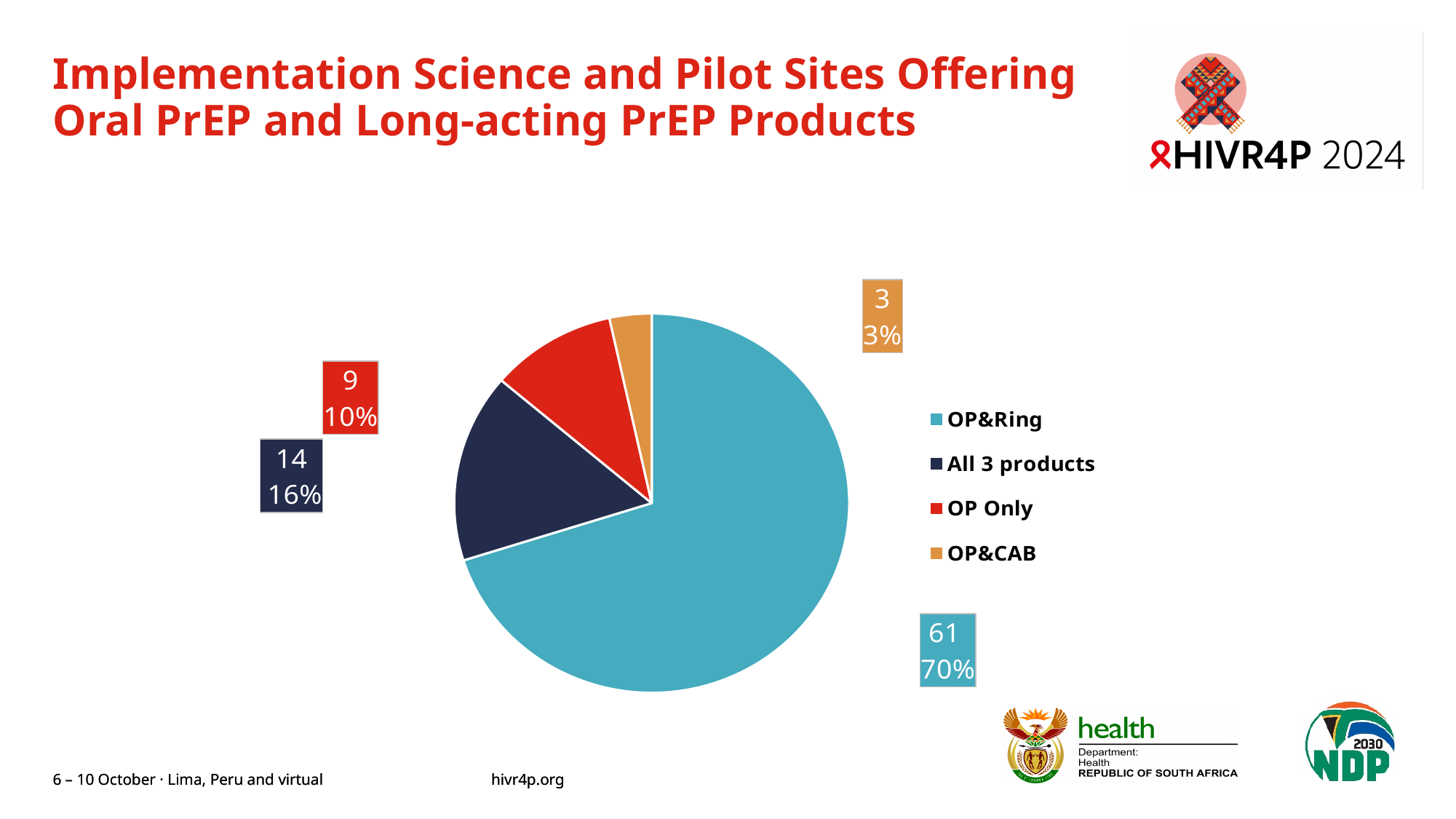
How many sites offer OP&Ring? 61 What is the difference in the number of sites between OP&Ring and All 3 products? 47 What percentage of sites offer all 3 products? 16% Which category has the largest slice of the pie? OP&Ring How many sites offer OP Only? 9 What share of the pie does OP&CAB represent? 3% What kind of chart is shown on the slide? pie chart Which has more sites, OP Only or OP&CAB? OP Only How many categories does the pie chart have? 4 Which category has the smallest slice of the pie? OP&CAB What is the total number of sites across all slices of the pie? 87 What colour is the OP Only slice? red